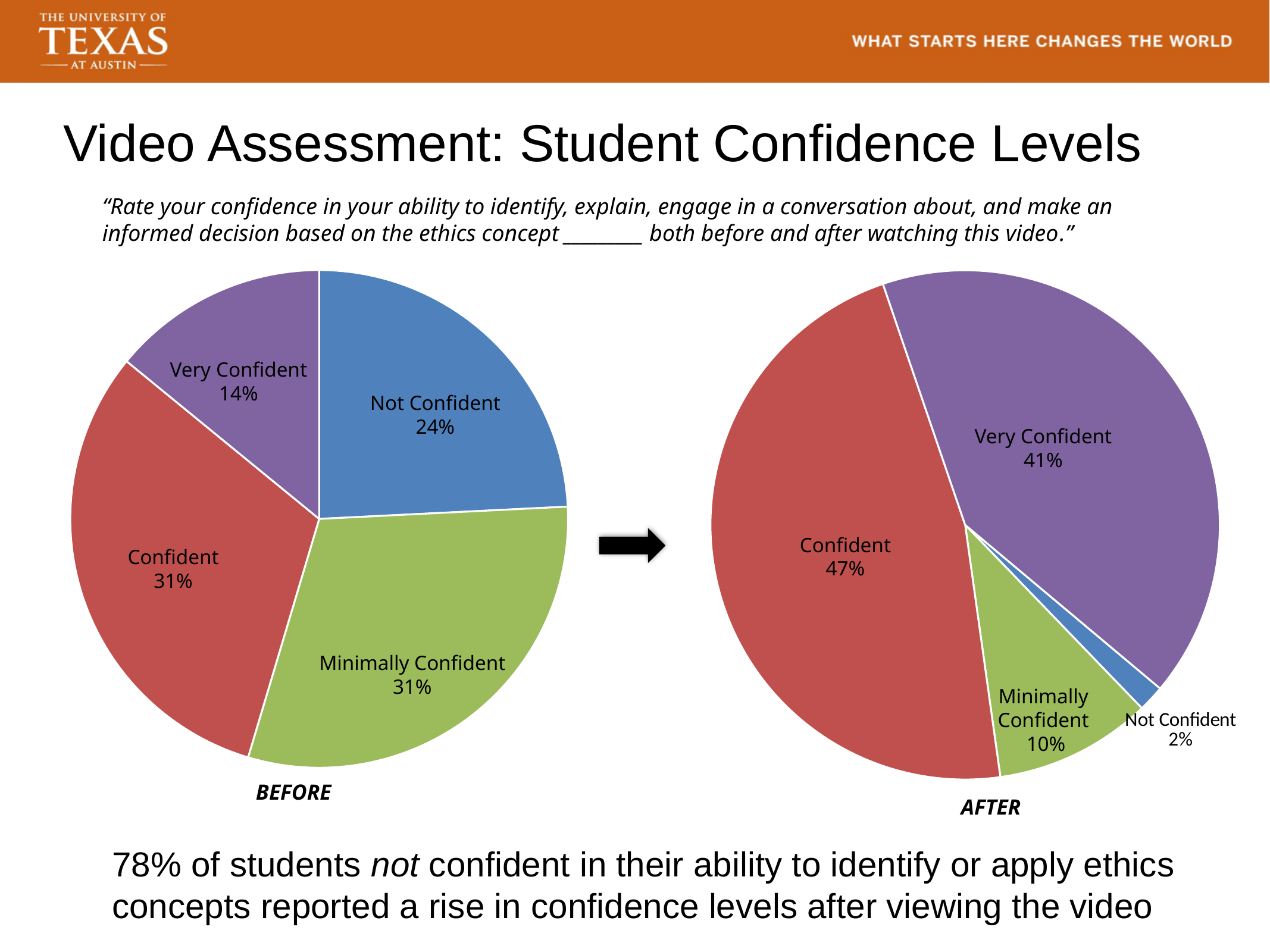
In the BEFORE pie chart, what share of students were Not Confident? 24% What colour is the Confident slice in the BEFORE pie chart? Red In the AFTER pie chart, what is the combined share of Confident and Very Confident students? 88% In the BEFORE pie chart, which is larger: the Not Confident share or the Very Confident share? Not Confident In the AFTER pie chart, what share of students were Minimally Confident? 10% What is the difference between the Very Confident share in the AFTER chart and the Very Confident share in the BEFORE chart? 27% In the AFTER pie chart, what share of students were Very Confident? 41% What type of chart is used for the BEFORE and AFTER data? Pie chart In the AFTER pie chart, which category has the largest share? Confident In the AFTER pie chart, which category has the smallest share? Not Confident How many slices does the BEFORE pie chart have? 4 In the BEFORE pie chart, which category has the smallest share? Very Confident